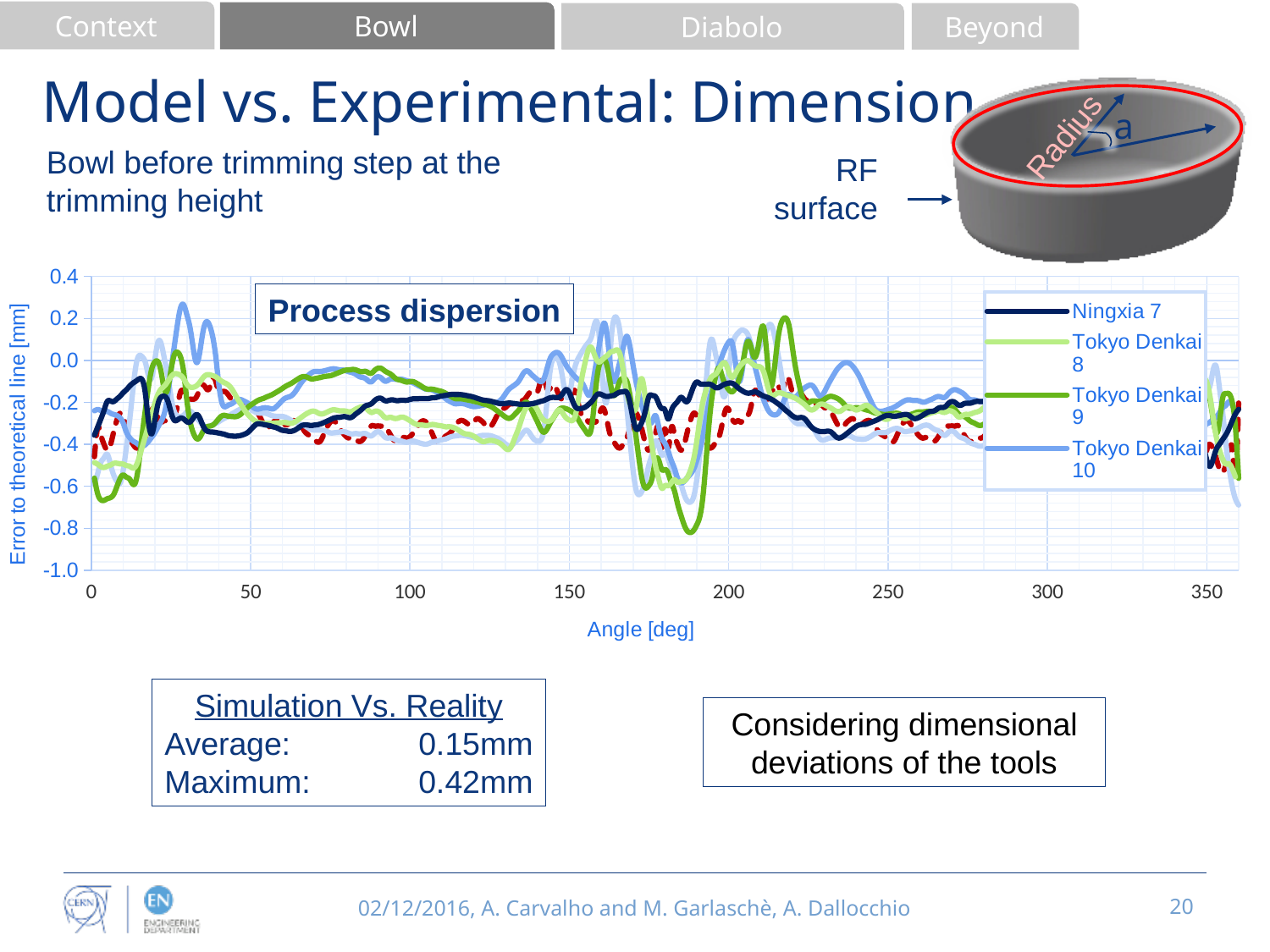
What kind of chart is shown on the slide? line chart Which series reaches the lowest value on the chart? Tokyo Denkai 9 Is the highest value reached by Tokyo Denkai 10 greater or less than 0.2? greater Is the value for Ningxia 7 at 0 degrees greater or less than -0.2? less What is the title of the x axis of the chart? Angle [deg] What label is written in the text box inside the chart area? Process dispersion Is the value for Tokyo Denkai 9 at 100 degrees greater or less than -0.2? greater How many series does the chart legend list? 4